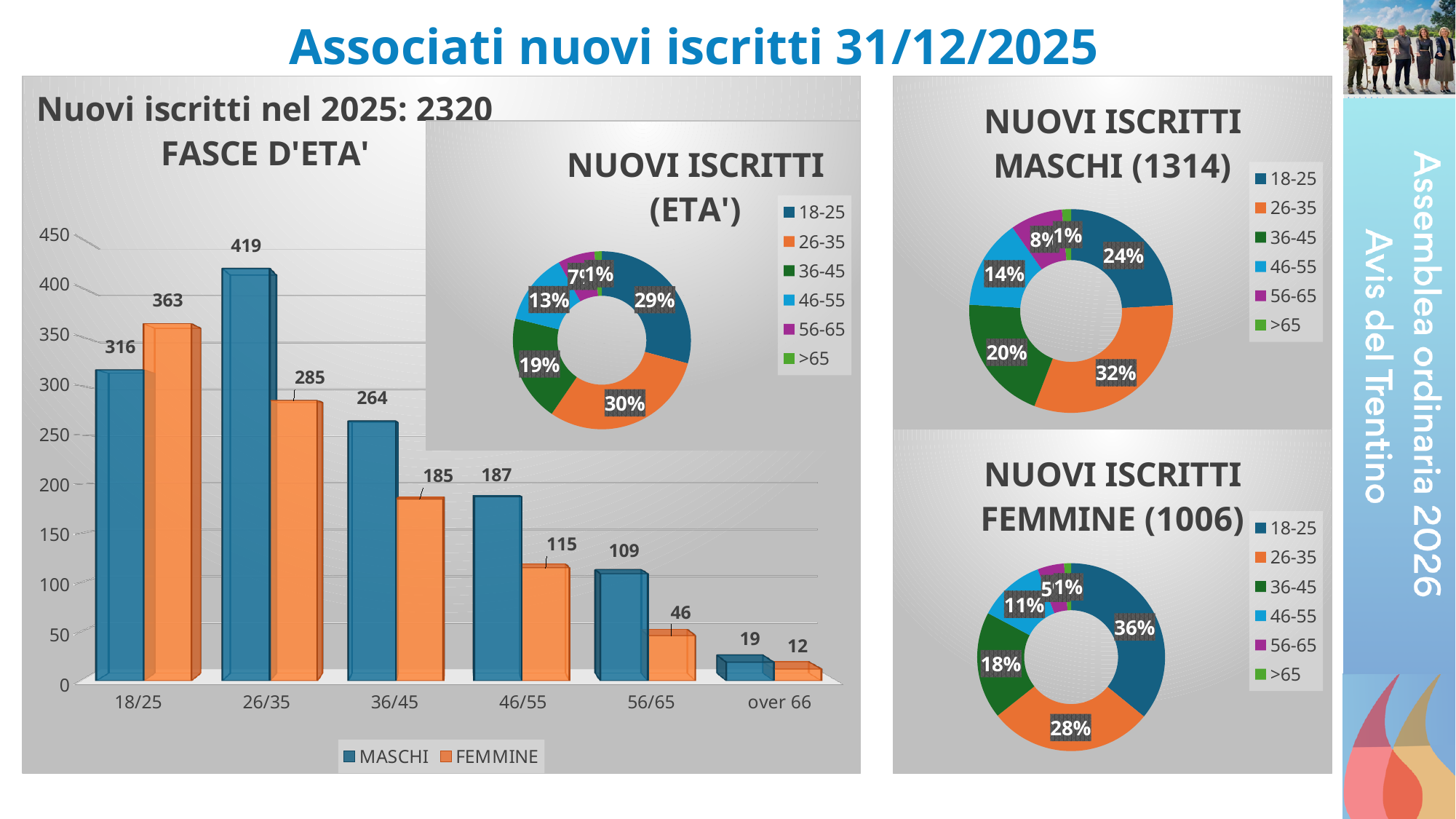
In the 'FASCE D'ETA'' bar chart, what is the MASCHI value for the 26/35 age group? 419 In the 'FASCE D'ETA'' bar chart, which is larger for the 18/25 age group: MASCHI or FEMMINE? FEMMINE What kind of chart is 'FASCE D'ETA''? bar chart In the 'NUOVI ISCRITTI FEMMINE (1006)' donut chart, which age group has the largest share? 18-25 In the 'NUOVI ISCRITTI (ETA')' donut chart, what share does the 26-35 group have? 30% How many series does the legend of the 'FASCE D'ETA'' chart list? 2 In the 'FASCE D'ETA'' bar chart, what is the FEMMINE value for the 18/25 age group? 363 In the 'FASCE D'ETA'' bar chart, what is the difference between the MASCHI and FEMMINE values for the 36/45 age group? 79 In the 'FASCE D'ETA'' bar chart, which age group has the lowest FEMMINE value? over 66 In the 'FASCE D'ETA'' bar chart, which age group has the highest MASCHI value? 26/35 In the 'NUOVI ISCRITTI MASCHI (1314)' donut chart, what share does the 46-55 group have? 14% How many age groups are shown on the x axis of the 'FASCE D'ETA'' bar chart? 6